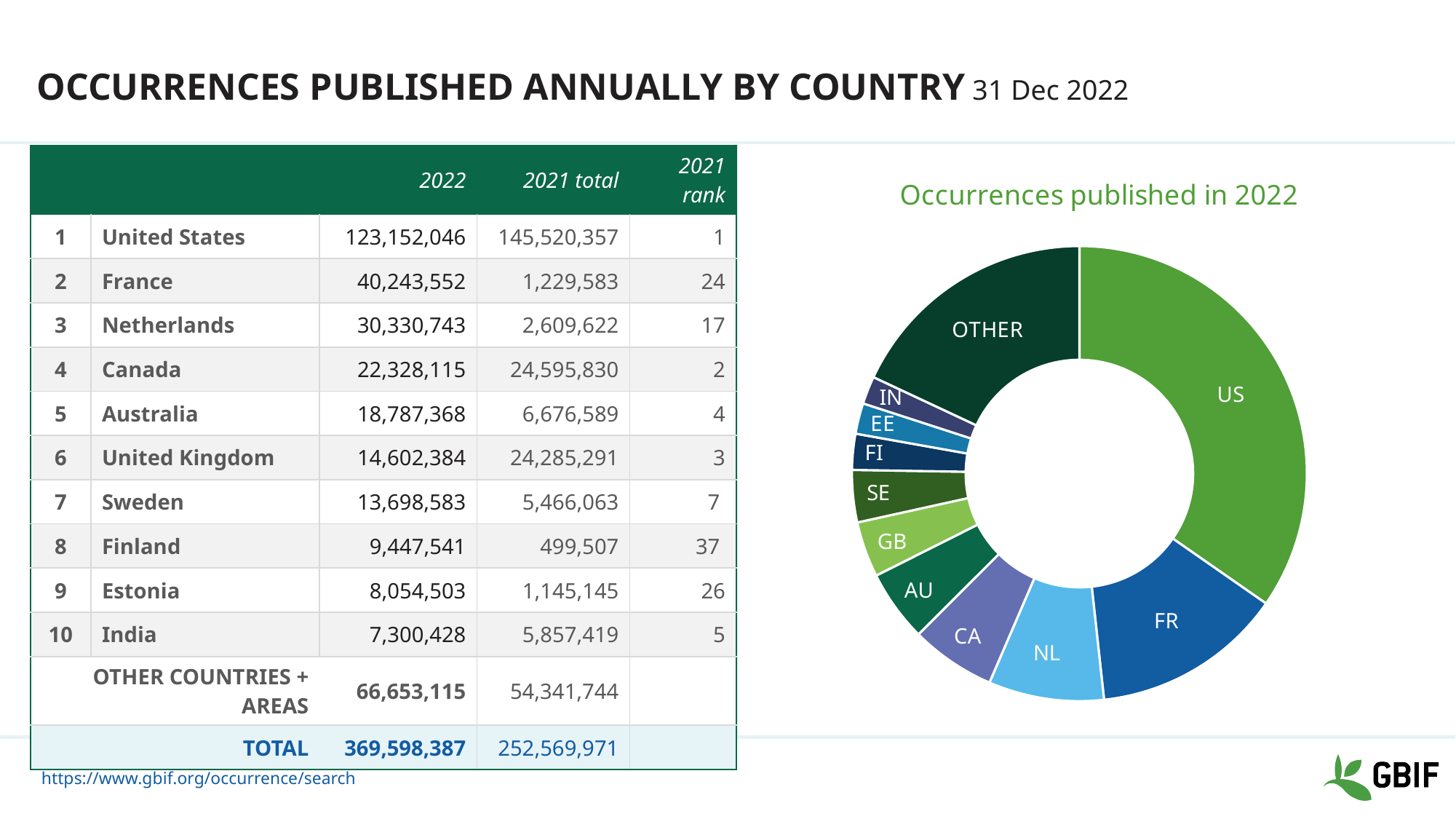
In the donut chart, which slice is larger, FR or NL? FR What kind of chart is shown on the right of the slide? Pie chart (donut) How many slices does the donut chart have? 11 According to the table, what is the 2022 value for Other countries + areas? 66,653,115 What colour is the US slice in the donut chart? Green Which slice of the donut chart is the largest? US According to the table, how many occurrences did the United States publish in 2022? 123,152,046 Using the table values, what is the difference between France's and the Netherlands' 2022 occurrences? 9,912,809 According to the table, how many occurrences did France publish in 2022? 40,243,552 In the donut chart, which slice is larger, OTHER or FR? OTHER In the donut chart, which slice is larger, US or OTHER? US What is the title of the chart on the right? Occurrences published in 2022